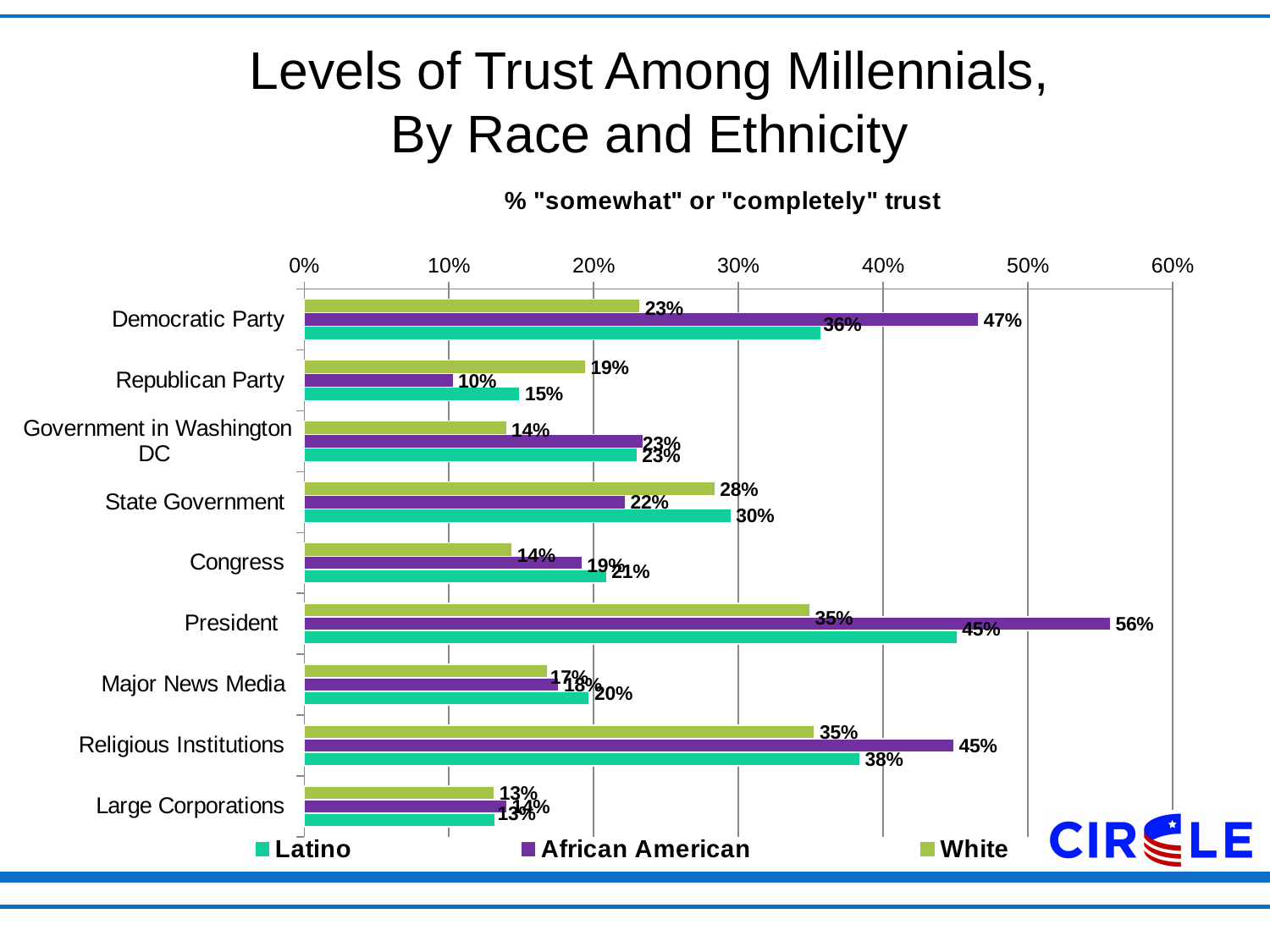
For Democratic Party, what is the difference between the African American value and the White value? 24 percentage points For Religious Institutions, which is larger: the African American value or the Latino value? African American Which category has the highest African American value? President What is the African American value for President? 56% Is the Latino value for President greater or less than 40%? greater How many series does the legend list? 3 What kind of chart is shown on the slide? bar chart What are the three series named in the legend? Latino, African American, White What is the Latino value for State Government? 30% Which category has the lowest African American value? Republican Party How many institutions (categories) are shown on the chart? 9 What is the White value for Republican Party? 19%